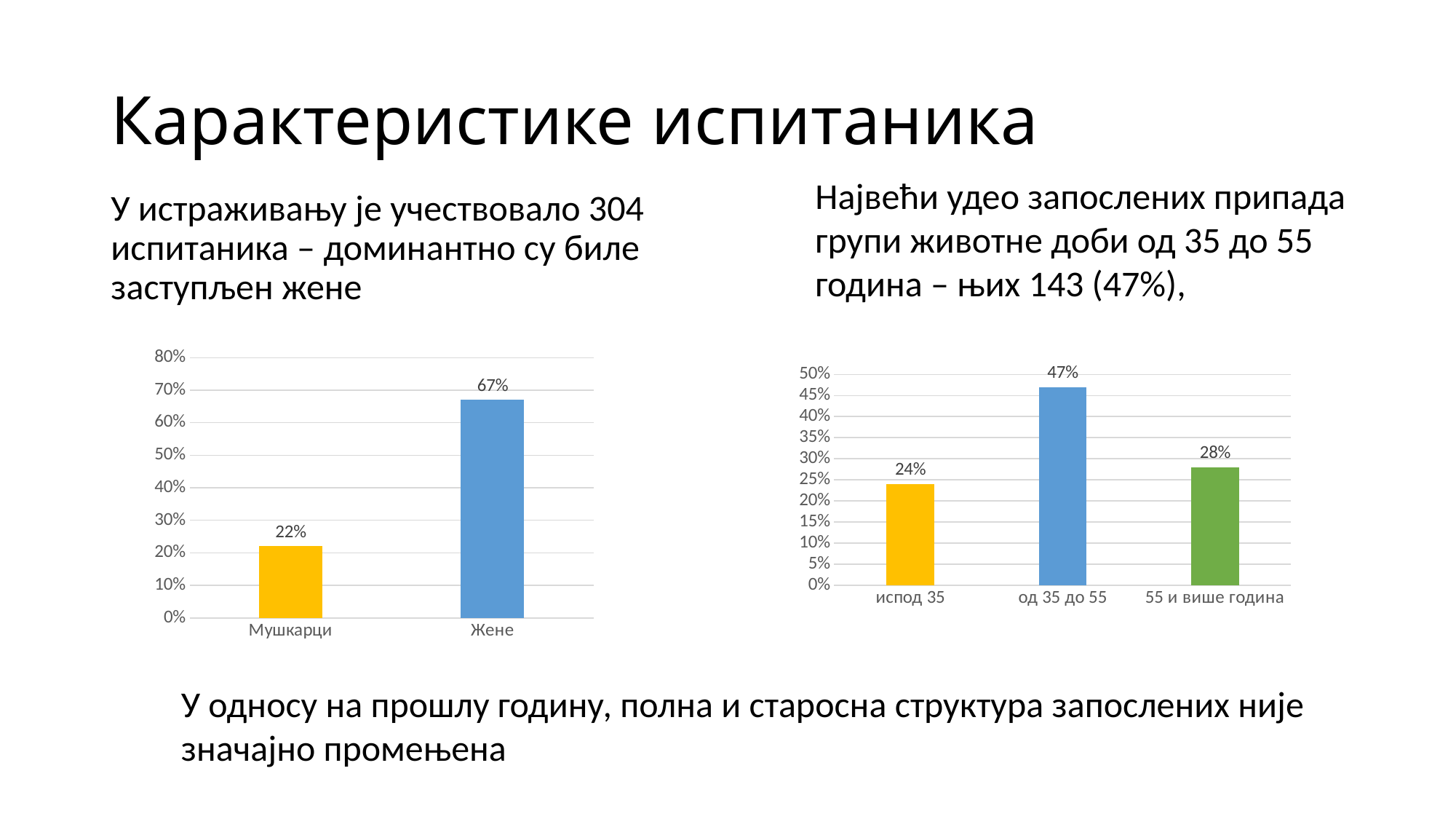
What kind of chart is the left chart (gender)? Bar chart In the left chart (gender), how many categories are shown? 2 In the right chart (age groups), which category has the lowest value? испод 35 In the right chart (age groups), which is larger: the value for испод 35 or for 55 и више година? 55 и више година In the left chart (gender), what is the value for Жене? 67% In the right chart (age groups), what is the value for 55 и више година? 28% In the right chart (age groups), what is the value for од 35 до 55? 47% In the left chart (gender), which category has the higher value? Жене In the left chart (gender), what is the difference between the values for Жене and Мушкарци? 45% In the right chart (age groups), how many categories are shown? 3 In the left chart (gender), what is the value for Мушкарци? 22% In the right chart (age groups), what is the difference between the values for од 35 до 55 and испод 35? 23%